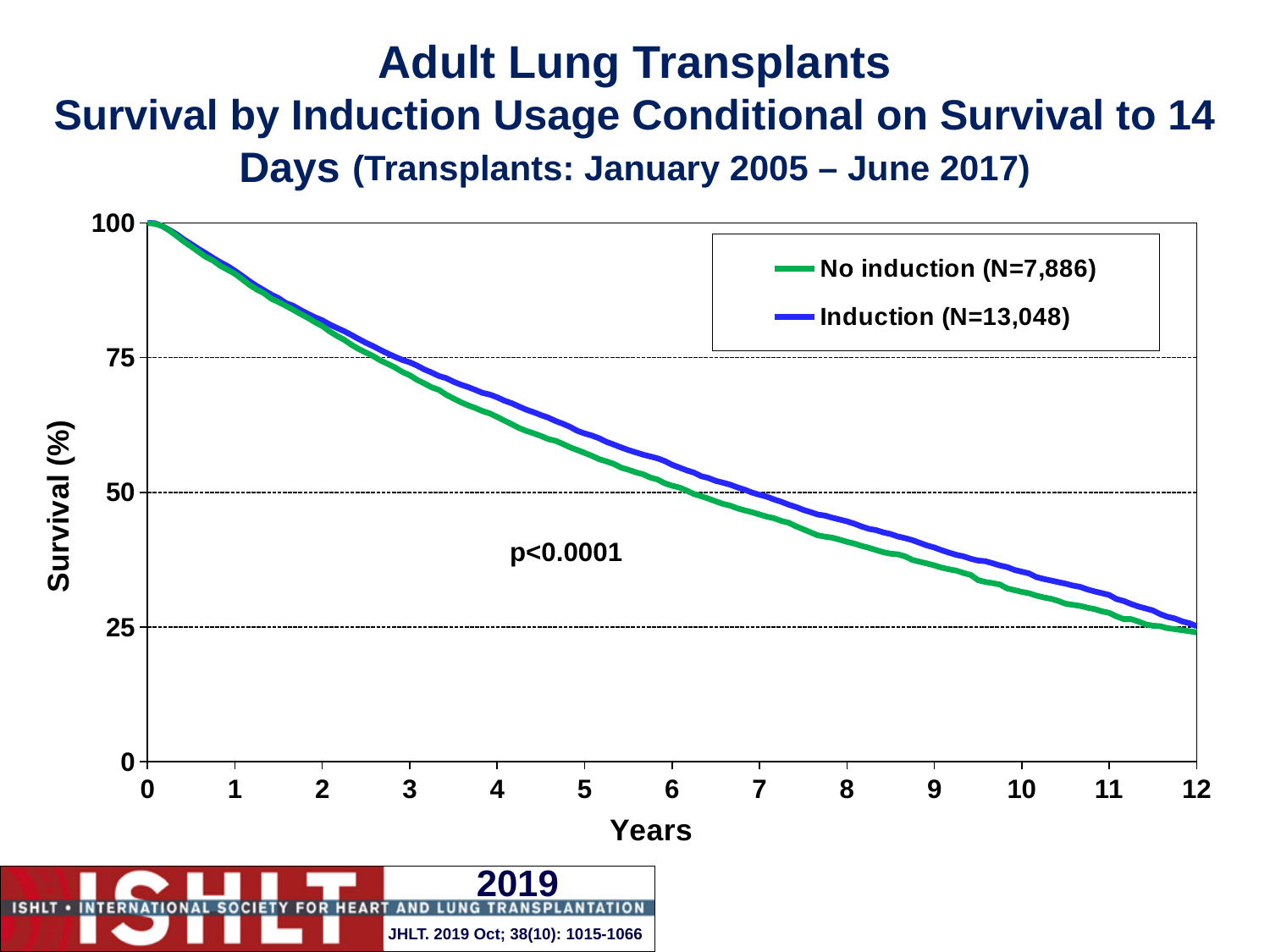
What is the label of the y-axis? Survival (%) At 8 years, which curve shows higher survival, No induction or Induction? Induction What p-value is printed on the chart? p<0.0001 At 8 years, is the survival for the No induction group greater or less than 50%? less At 4 years, is the survival for the Induction group greater or less than 50%? greater Which group has the larger sample size, No induction or Induction? Induction At 2 years, is the survival for the Induction group greater or less than 75%? greater How many series does the legend list? 2 What is the sample size (N) for the Induction group shown in the legend? 13,048 Do the survival curves rise or fall as years increase? Fall What is the sample size (N) for the No induction group shown in the legend? 7,886 What kind of chart is shown on the slide? Line chart